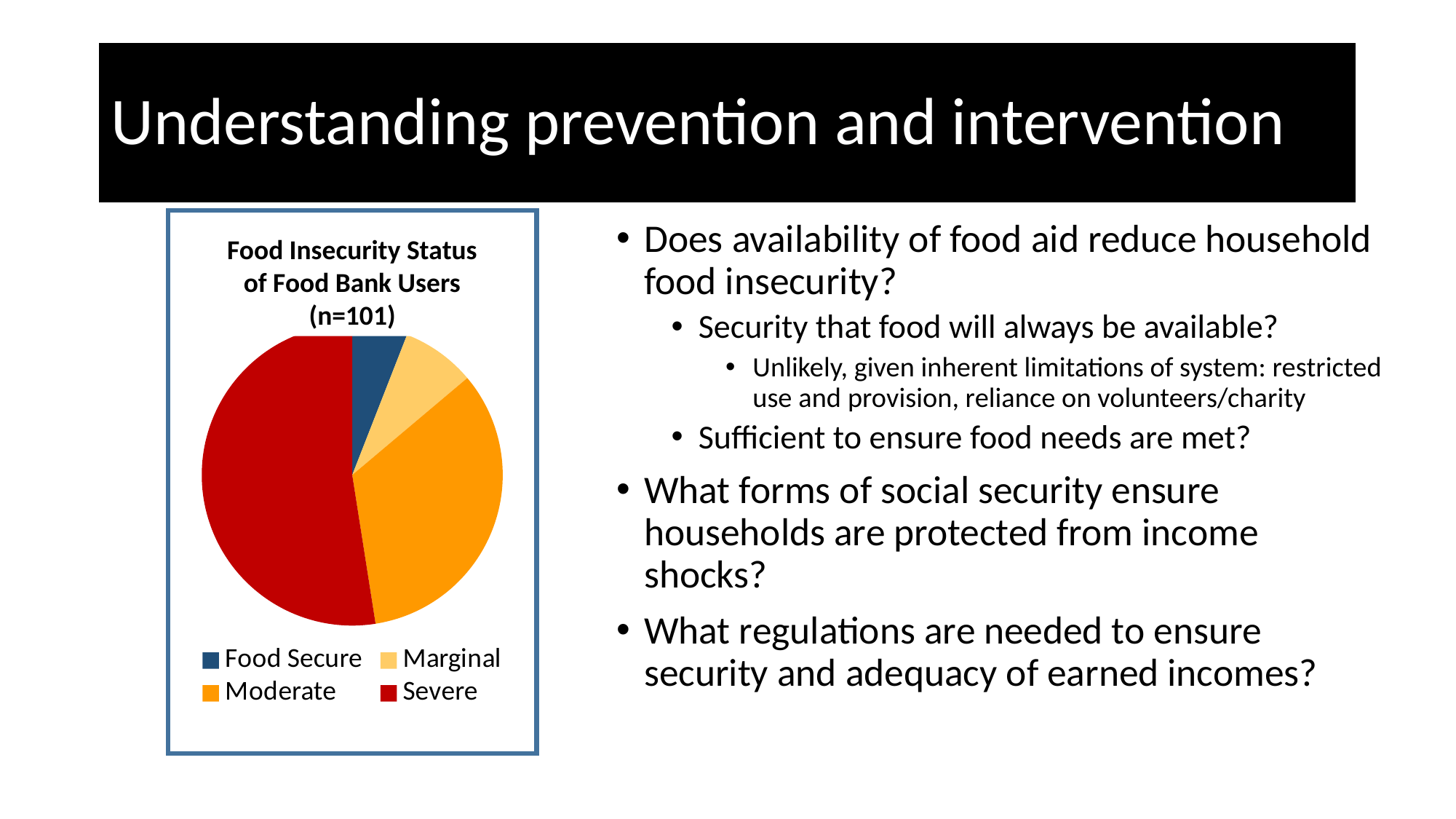
Which slice is larger, Moderate or Food Secure? Moderate What kind of chart is shown on the slide? pie chart Which category is shown in the legend alongside Food Secure, Marginal and Moderate? Severe Which slice is larger, Severe or Moderate? Severe How many categories does the pie chart show? 4 What is the title of the chart? Food Insecurity Status of Food Bank Users (n=101) Which slice is larger, Severe or Food Secure? Severe What sample size is given in the chart title? n=101 Which category has the largest slice of the pie? Severe